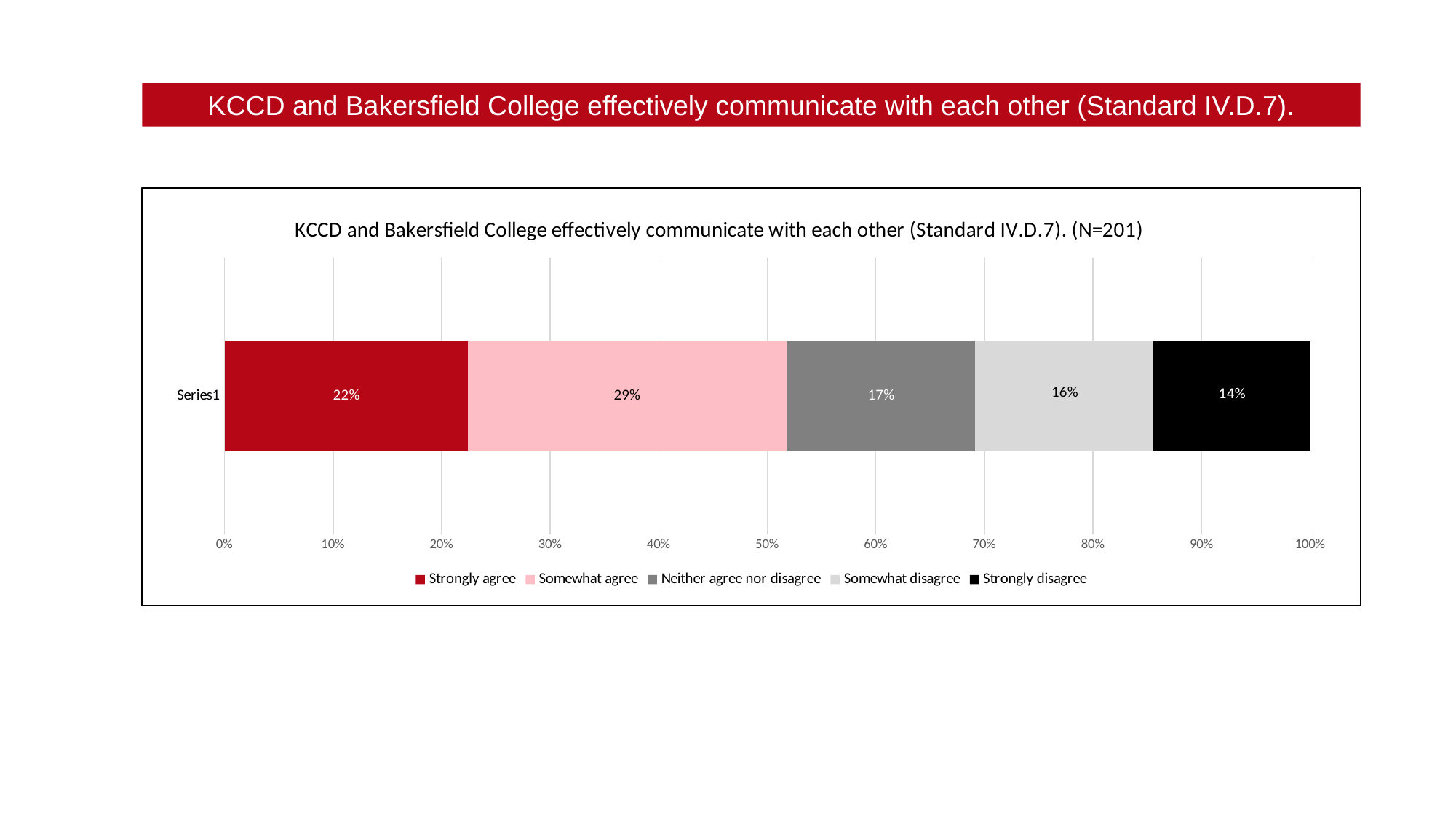
What is the difference in percentage points between "Somewhat agree" and "Strongly agree"? 7 What percentage of respondents selected "Strongly agree"? 22% How many response categories does the legend list? 5 Which response category has the smallest share? Strongly disagree What percentage of respondents selected "Neither agree nor disagree"? 17% What percentage of respondents selected "Strongly disagree"? 14% What kind of chart is shown on the slide? Stacked bar chart What is the combined percentage of "Strongly agree" and "Somewhat agree" responses? 51% What percentage of respondents selected "Somewhat agree"? 29% What percentage of respondents selected "Somewhat disagree"? 16% Which is larger, the share for "Strongly agree" or the share for "Neither agree nor disagree"? Strongly agree Which response category has the largest share? Somewhat agree